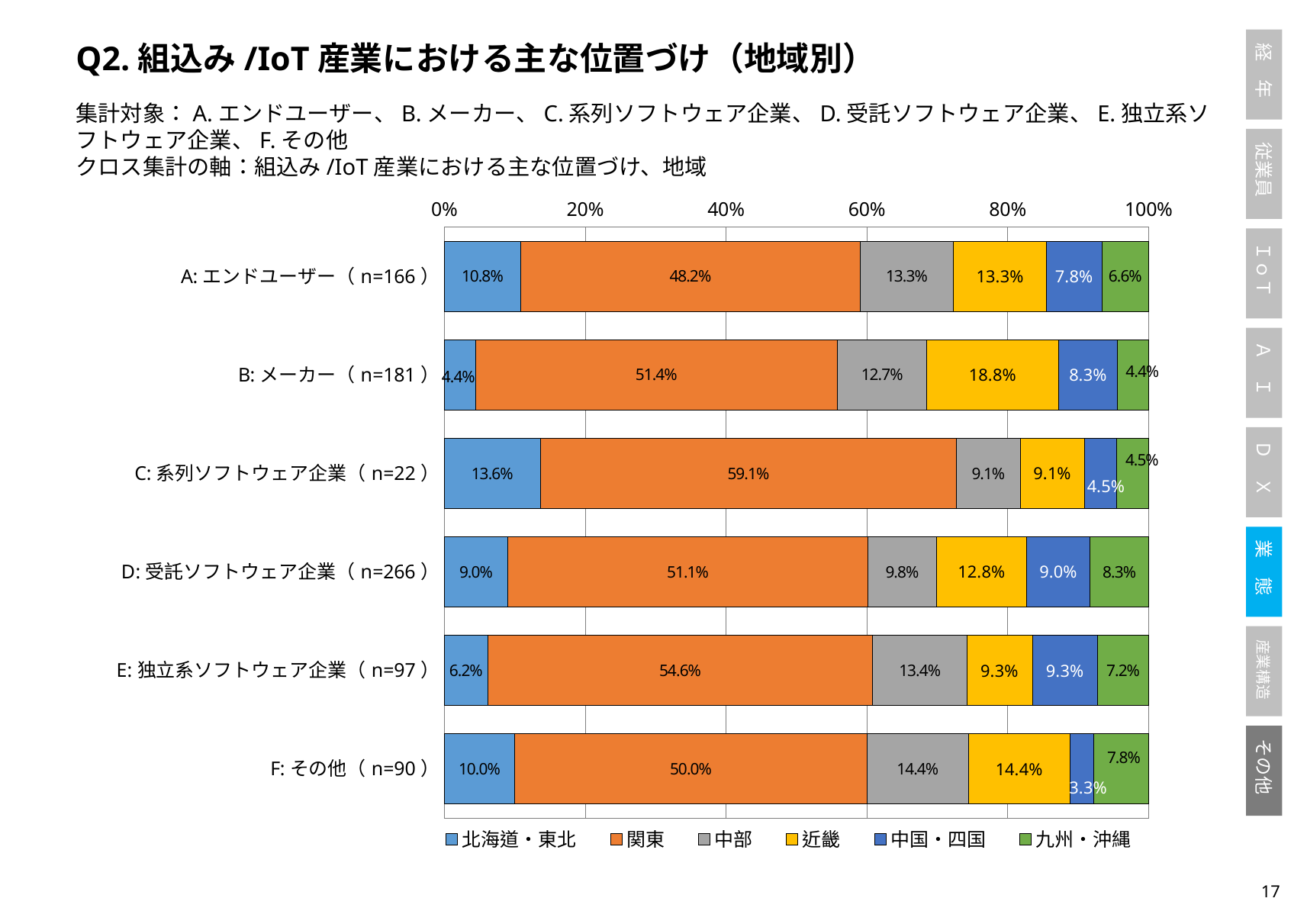
Which is larger: the 中部 share for F: その他 or the 中部 share for D: 受託ソフトウェア企業? F: その他 What is the difference between the 関東 share of E: 独立系ソフトウェア企業 and that of F: その他? 4.6% Which category has the lowest 北海道・東北 share? B: メーカー (n=181) What is the 近畿 share for B: メーカー (n=181)? 18.8% What is the 関東 share for A: エンドユーザー (n=166)? 48.2% Which legend entry is shown in orange? 関東 How many categories (bars) are plotted on the chart? 6 What is the 北海道・東北 share for C: 系列ソフトウェア企業 (n=22)? 13.6% What is the 九州・沖縄 share for D: 受託ソフトウェア企業 (n=266)? 8.3% How many series does the legend list? 6 Which category has the highest 関東 share? C: 系列ソフトウェア企業 (n=22) What kind of chart is shown on the slide? Stacked bar chart